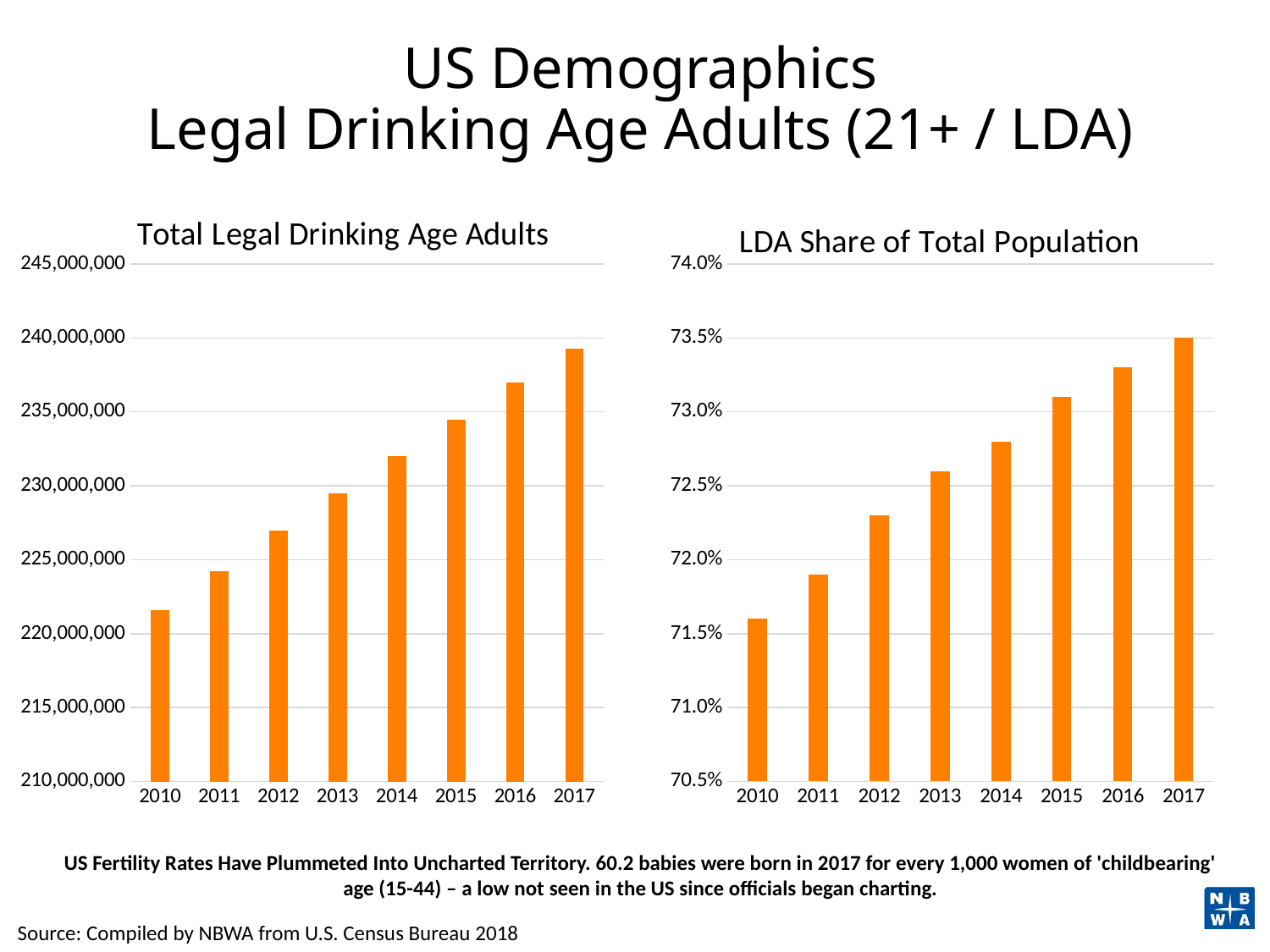
In the 'LDA Share of Total Population' chart, which year has the lowest share? 2010 In the 'LDA Share of Total Population' chart, is the value for 2017 greater or less than 73.0%? greater In the 'Total Legal Drinking Age Adults' chart, is the value for 2017 greater or less than 240,000,000? less In the 'Total Legal Drinking Age Adults' chart, how many years are plotted? 8 In the 'Total Legal Drinking Age Adults' chart, what kind of chart is shown? bar chart In the 'Total Legal Drinking Age Adults' chart, is the value for 2014 greater or less than 230,000,000? greater In the 'LDA Share of Total Population' chart, which is larger, the value for 2013 or the value for 2016? 2016 In the 'Total Legal Drinking Age Adults' chart, do the values rise or fall from 2010 to 2017? rise In the 'Total Legal Drinking Age Adults' chart, which year has the lowest value? 2010 In the 'Total Legal Drinking Age Adults' chart, which year has the highest value? 2017